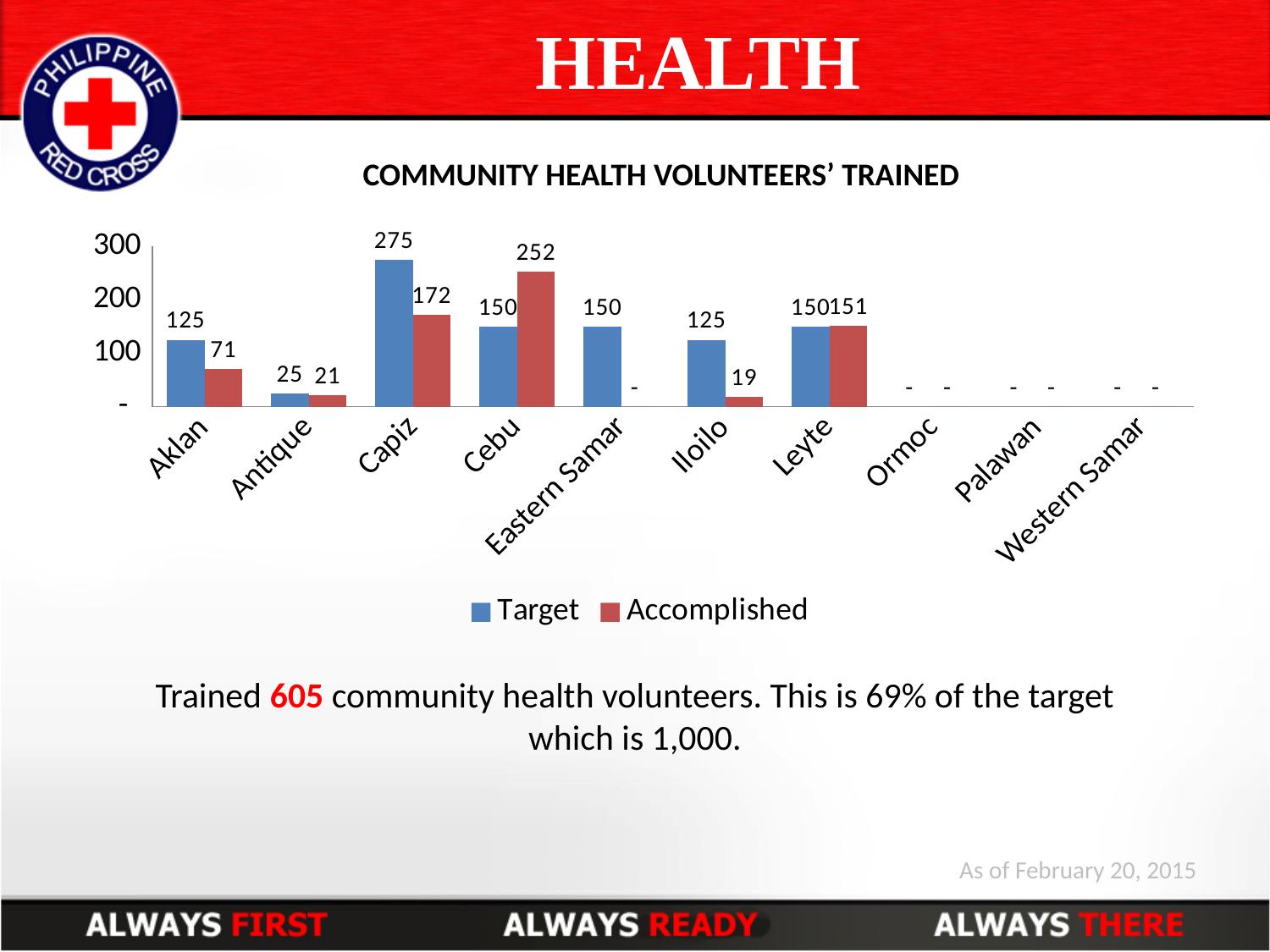
What is the Target value for Antique? 25 Which category has the highest Target value? Capiz What is the Accomplished value for Cebu? 252 What is the difference between the Target and Accomplished values for Capiz? 103 Which is larger for Cebu, the Target or the Accomplished value? Accomplished Which category has the highest Accomplished value? Cebu How many categories are shown on the x axis? 10 What is the difference between the Target and Accomplished values for Aklan? 54 What kind of chart is shown on the slide? Bar chart How many series does the legend list? 2 What is the Accomplished value for Iloilo? 19 What is the Target value for Capiz? 275